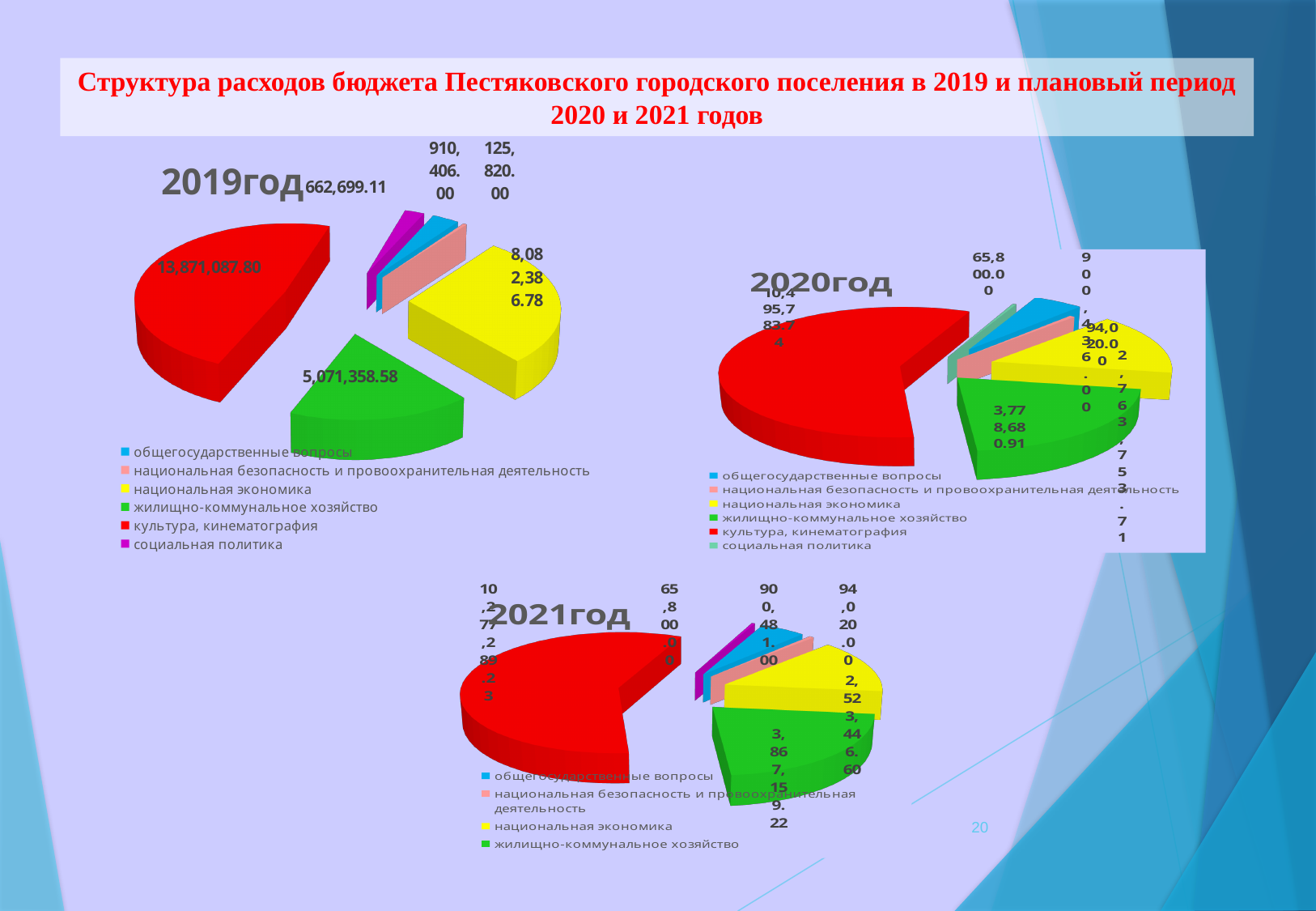
In the 2019год chart, what is the value for культура, кинематография? 13,871,087.80 In the 2020год chart, which category has the largest slice? культура, кинематография In the 2019год chart, what is the difference between культура, кинематография and национальная экономика? 5,788,701.02 How many entries does the legend of the 2019год chart list? 6 In the 2020год chart, what is the value for жилищно-коммунальное хозяйство? 3,778,680.91 In the 2019год chart, what is the value for жилищно-коммунальное хозяйство? 5,071,358.58 What kind of chart is the 2019год chart? pie chart How many pie charts are shown on the slide? 3 In the 2019год chart, which category has the largest slice? культура, кинематография In the 2021год chart, what is the value for жилищно-коммунальное хозяйство? 3,867,159.22 In the 2019год chart, what is the value for национальная экономика? 8,082,386.78 In the 2019год chart, which is larger: жилищно-коммунальное хозяйство or национальная экономика? национальная экономика